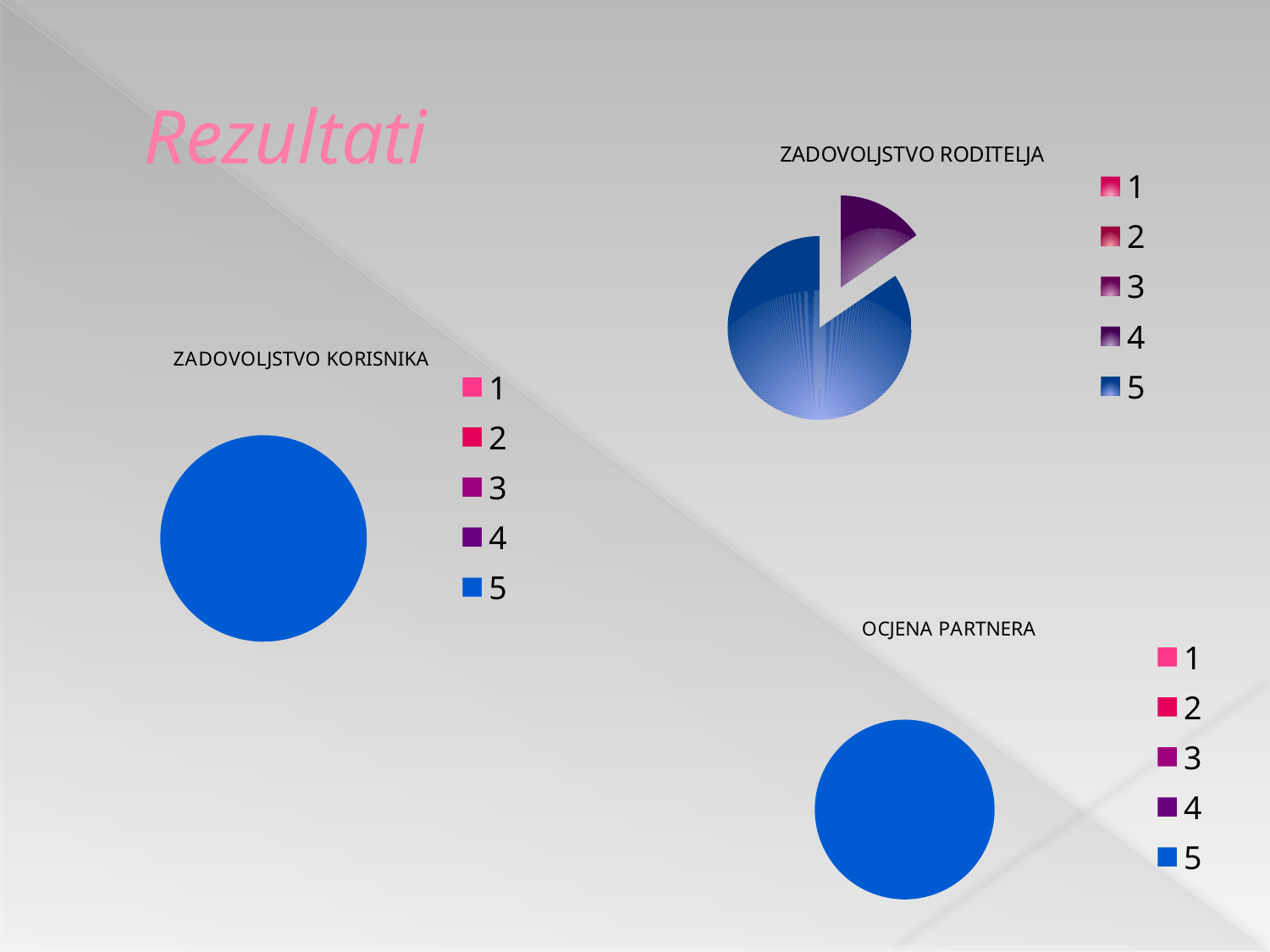
In the "ZADOVOLJSTVO RODITELJA" chart, how many entries does the legend list? 5 What kind of chart is the "OCJENA PARTNERA" chart? pie chart What kind of chart is the "ZADOVOLJSTVO KORISNIKA" chart? pie chart In the "OCJENA PARTNERA" chart, how many entries does the legend list? 5 What is the title of the chart in the bottom right of the slide? OCJENA PARTNERA In the "ZADOVOLJSTVO RODITELJA" chart, how many slices are visible in the pie? 2 In the "ZADOVOLJSTVO KORISNIKA" chart, which category has the largest slice? 5 In the "ZADOVOLJSTVO RODITELJA" chart, which category has the largest slice? 5 What kind of chart is the "ZADOVOLJSTVO RODITELJA" chart? pie chart In the "ZADOVOLJSTVO KORISNIKA" chart, how many entries does the legend list? 5 In the "ZADOVOLJSTVO RODITELJA" chart, which slice is larger, category 4 or category 5? 5 In the "OCJENA PARTNERA" chart, which category has the largest slice? 5